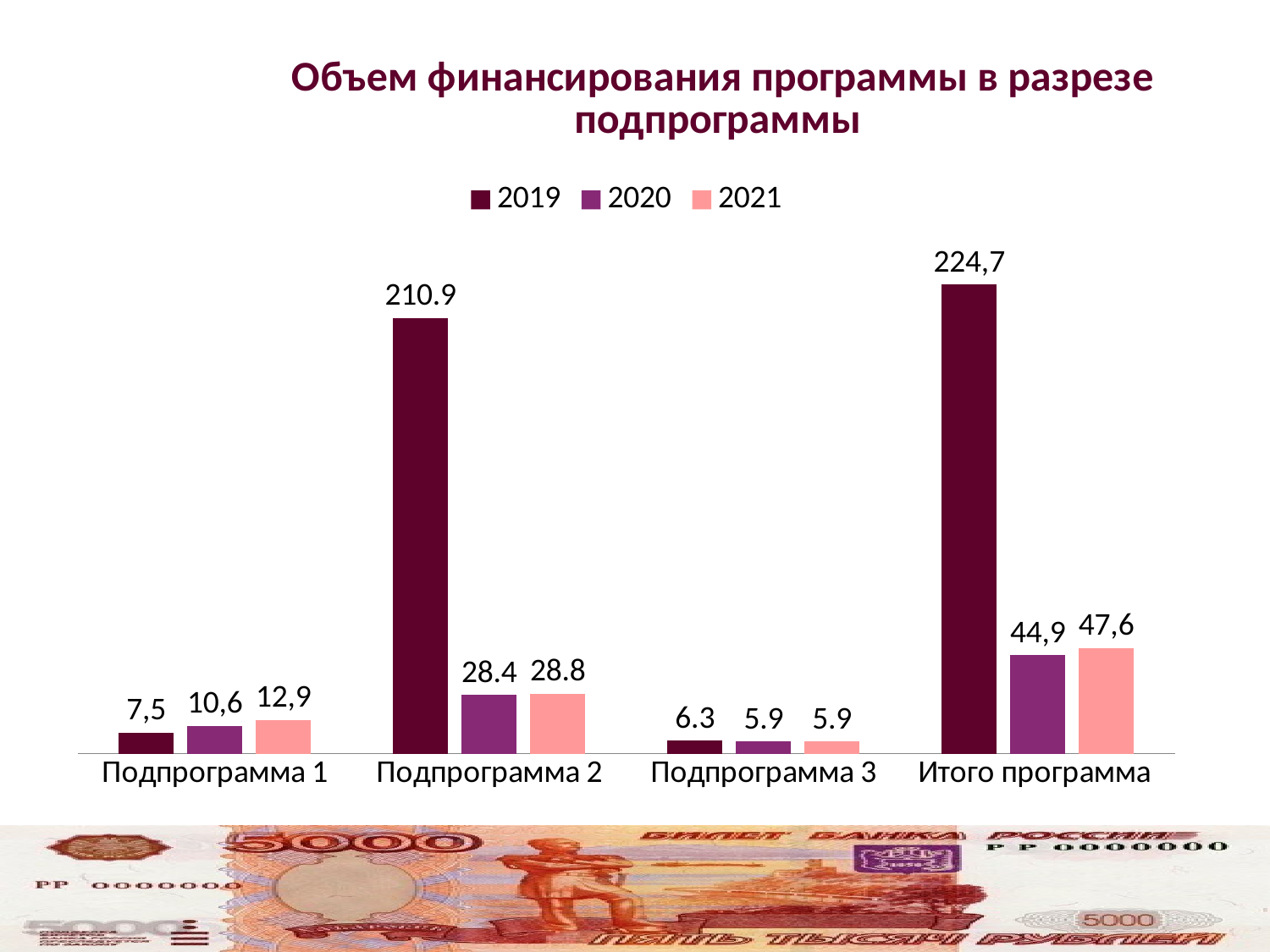
What is the value for Подпрограмма 2 in the 2019 series? 210.9 What is the difference between the 2021 and 2019 values for Подпрограмма 1? 5,4 What is the value for Подпрограмма 3 in the 2019 series? 6.3 How many categories are shown on the x axis? 4 Which is larger for Итого программа: the 2020 value or the 2021 value? 2021 What is the difference between the 2021 and 2020 values for Подпрограмма 2? 0.4 How many series does the legend list? 3 Which category has the highest value in the 2019 series? Итого программа What is the value for Подпрограмма 1 in the 2020 series? 10,6 What is the value for Итого программа in the 2021 series? 47,6 Which category has the lowest value in the 2021 series? Подпрограмма 3 What kind of chart is shown on the slide? Bar chart